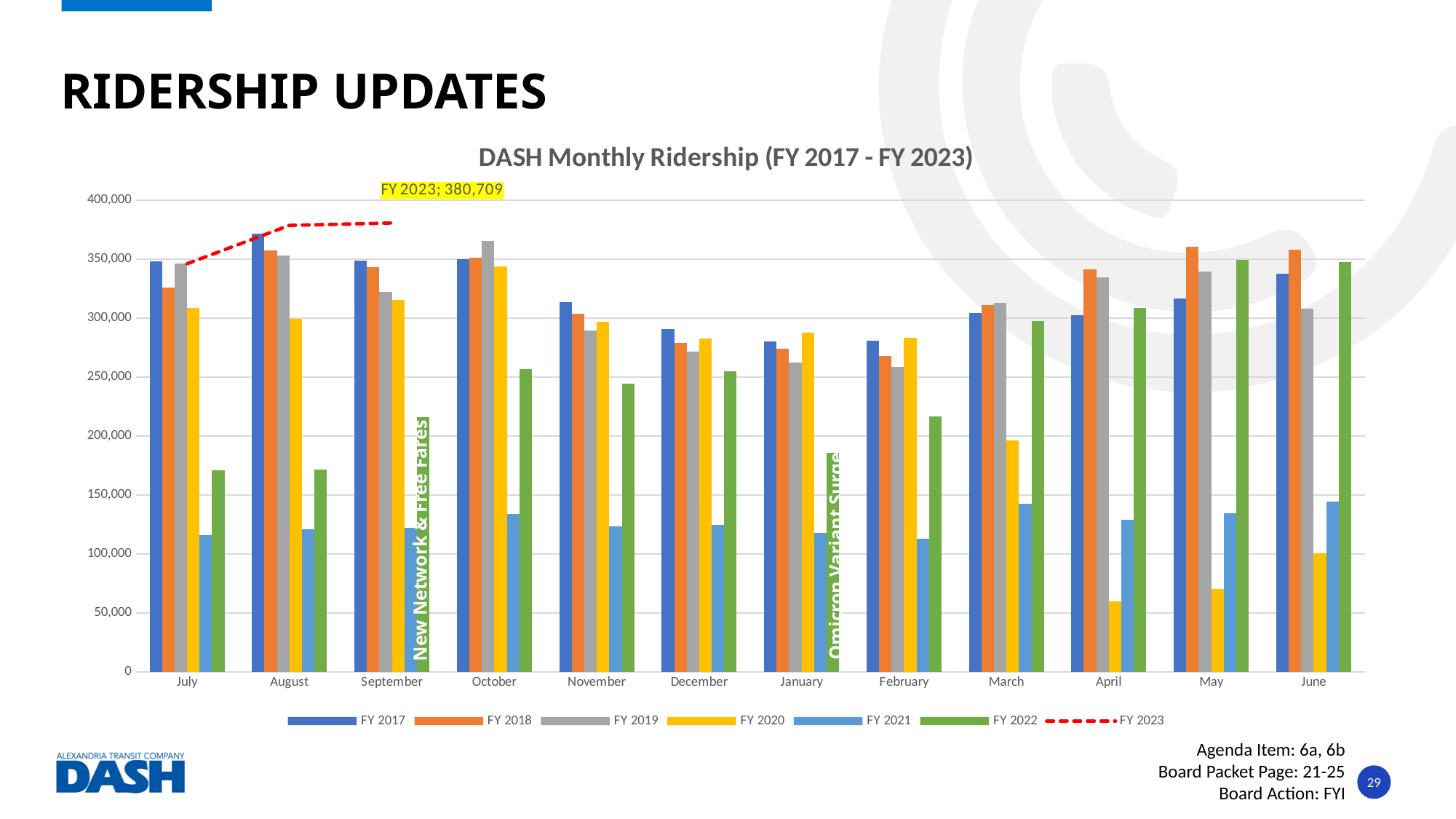
What is the title of the chart? DASH Monthly Ridership (FY 2017 - FY 2023) How many series does the legend list? 7 For FY 2020, which month had higher ridership: March or April? March Which series is shown as a red dashed line? FY 2023 What kind of chart is used to show the FY 2017 to FY 2022 ridership? bar chart Which fiscal year had the highest ridership in October? FY 2019 Is the FY 2021 ridership for July greater or less than 150,000? less What is the labelled FY 2023 ridership value shown on the chart? 380,709 How many months are shown along the x axis? 12 Is the FY 2018 ridership for May greater or less than 350,000? greater Is the FY 2022 ridership for May greater or less than 300,000? greater Which fiscal year had the lowest ridership in April? FY 2020